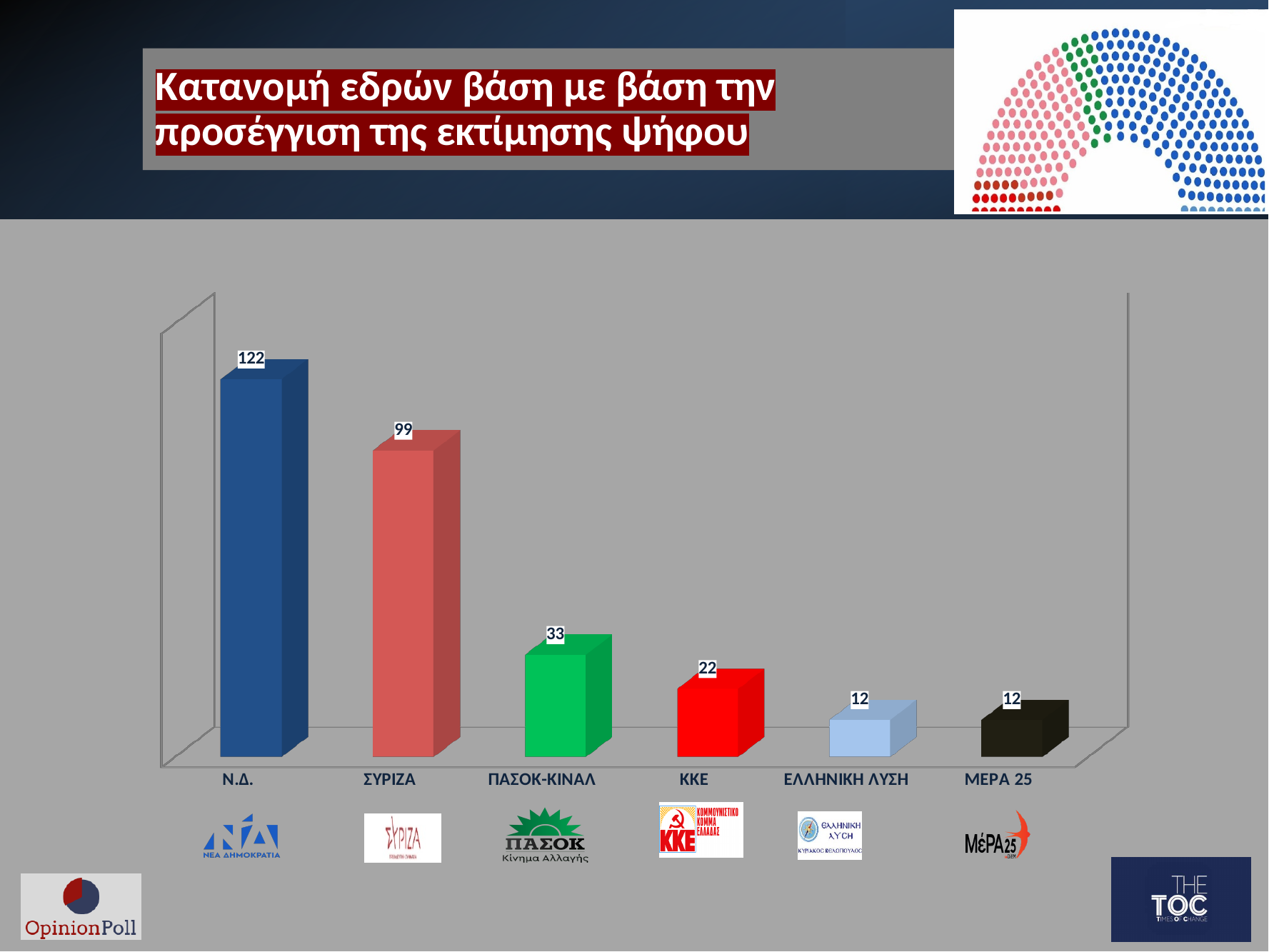
What kind of chart is shown on the slide? Bar chart Which has more seats, ΣΥΡΙΖΑ or ΠΑΣΟΚ-ΚΙΝΑΛ? ΣΥΡΙΖΑ What is the value shown for ΚΚΕ? 22 What is the value shown for ΠΑΣΟΚ-ΚΙΝΑΛ? 33 What is the value shown for ΕΛΛΗΝΙΚΗ ΛΥΣΗ? 12 How many seats does the chart show for Ν.Δ.? 122 Which party has the highest number of seats in the chart? Ν.Δ. What is the value shown for ΣΥΡΙΖΑ? 99 How many parties (categories) are shown in the chart? 6 What colour is the bar for ΠΑΣΟΚ-ΚΙΝΑΛ? Green What is the difference in seats between ΠΑΣΟΚ-ΚΙΝΑΛ and ΚΚΕ? 11 What is the difference in seats between Ν.Δ. and ΣΥΡΙΖΑ? 23